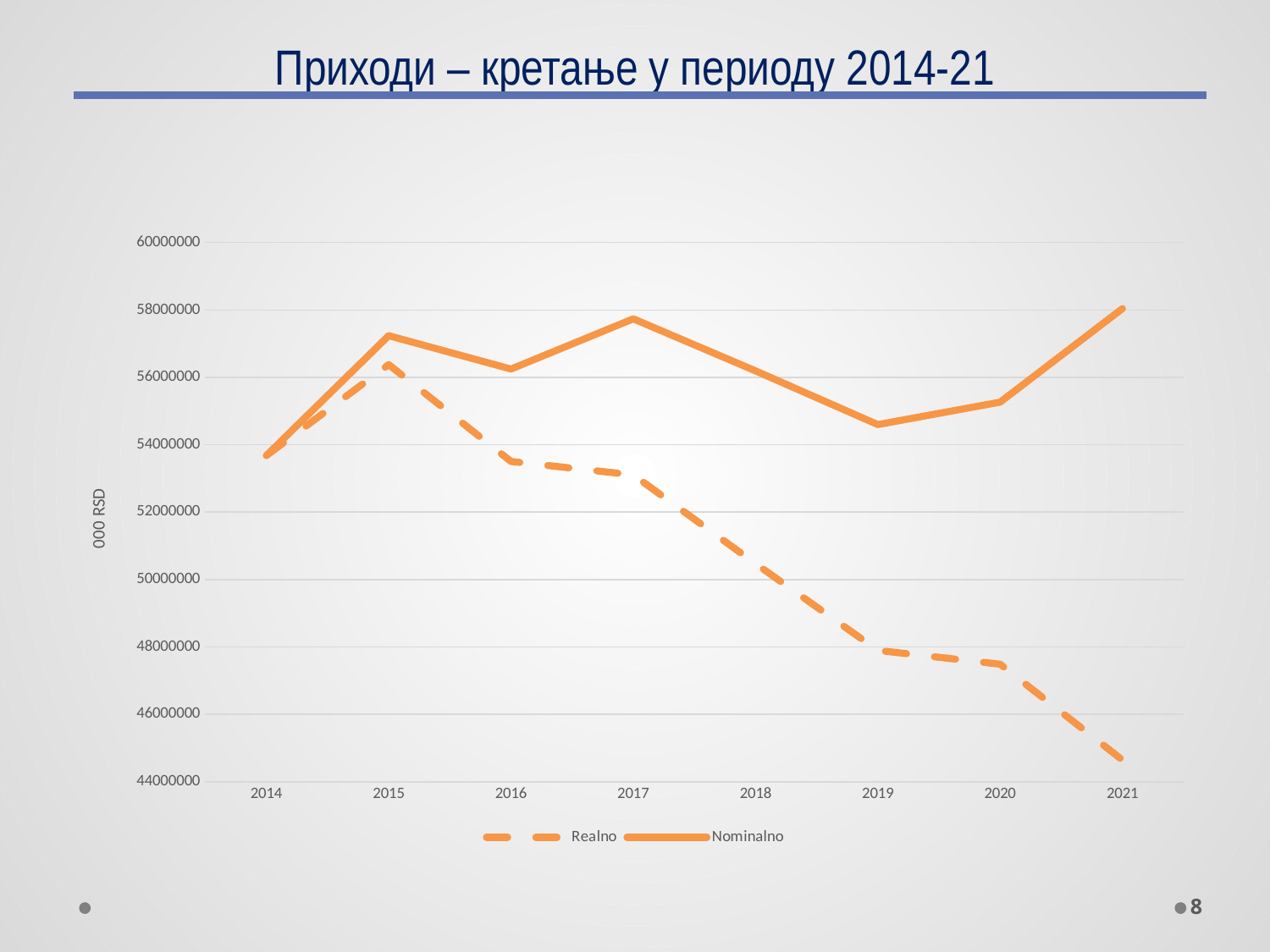
How many series does the legend list? 2 In 2019, which series has the larger value, Realno or Nominalno? Nominalno Does the Realno series rise or fall from 2015 to 2021? fall In which year does the Realno series reach its lowest value? 2021 What is the label on the vertical axis? 000 RSD In which year does the Nominalno series reach its lowest value? 2014 Is the Realno value for 2021 greater or less than 46000000? less Is the Nominalno value for 2021 greater or less than 56000000? greater In which year does the Realno series reach its highest value? 2015 What kind of chart is shown on the slide? line chart Is the Realno value for 2018 greater or less than 52000000? less How many years are plotted along the x axis? 8